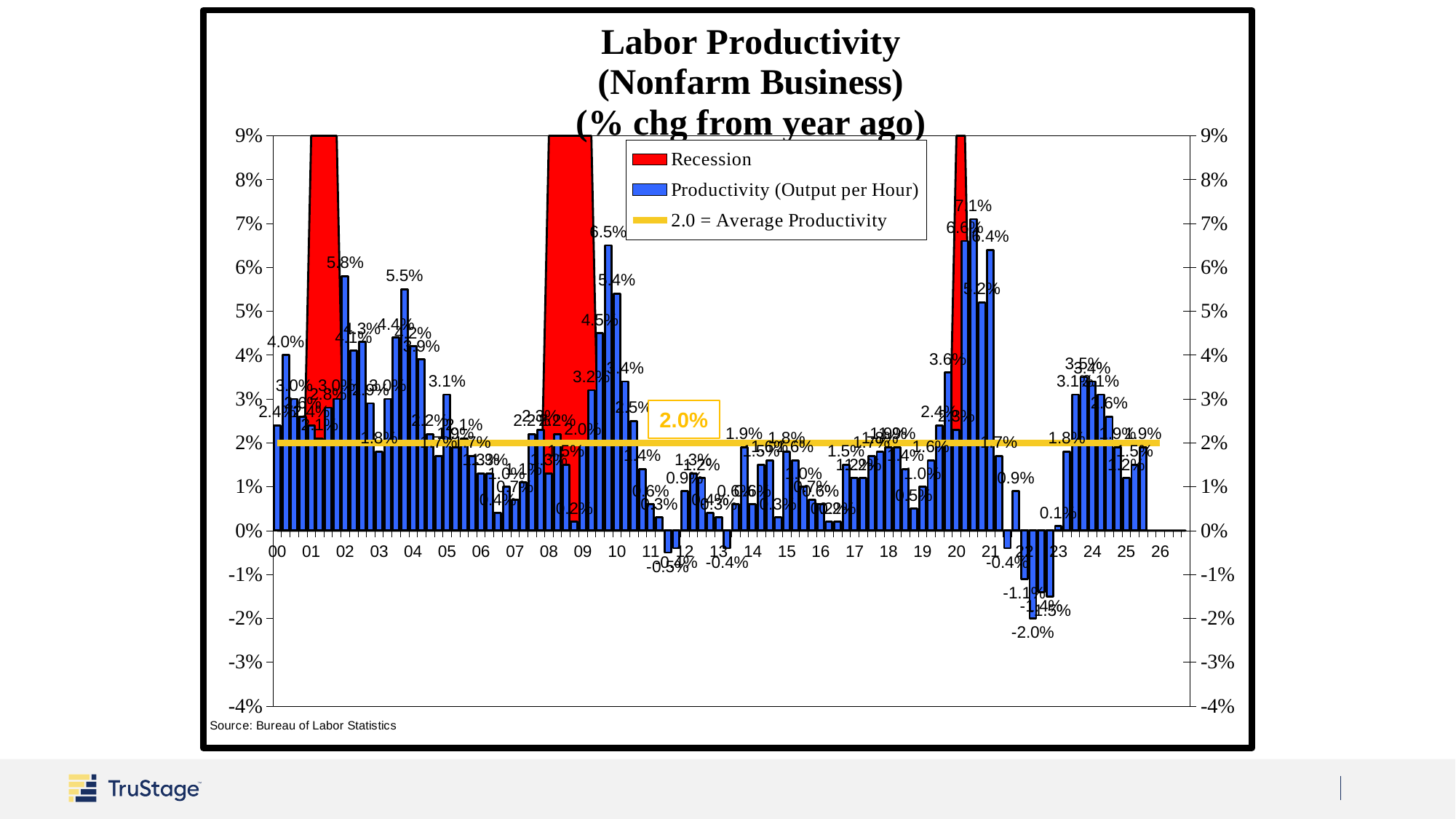
What is the difference between the highest labeled value (7.1%) and the lowest labeled value (-2.0%)? 9.1 percentage points What source is cited for the chart data? Bureau of Labor Statistics What kind of chart is shown on the slide? Bar chart What colour is used to mark recession periods? Red What is the lowest labeled productivity value on the chart? -2.0% How many recession periods are shaded on the chart? 3 What is the highest labeled productivity value on the chart? 7.1% What value does the yellow average productivity line mark? 2.0% How many entries does the legend list? 3 Is the 6.4% bar in 2021 greater or less than 6%? greater Which is larger, the 5.8% peak around 2002 or the 5.5% peak around 2004? 5.8% Did productivity rise or fall from the 7.1% peak in 2020-21 to the -2.0% low in 2022? Fall